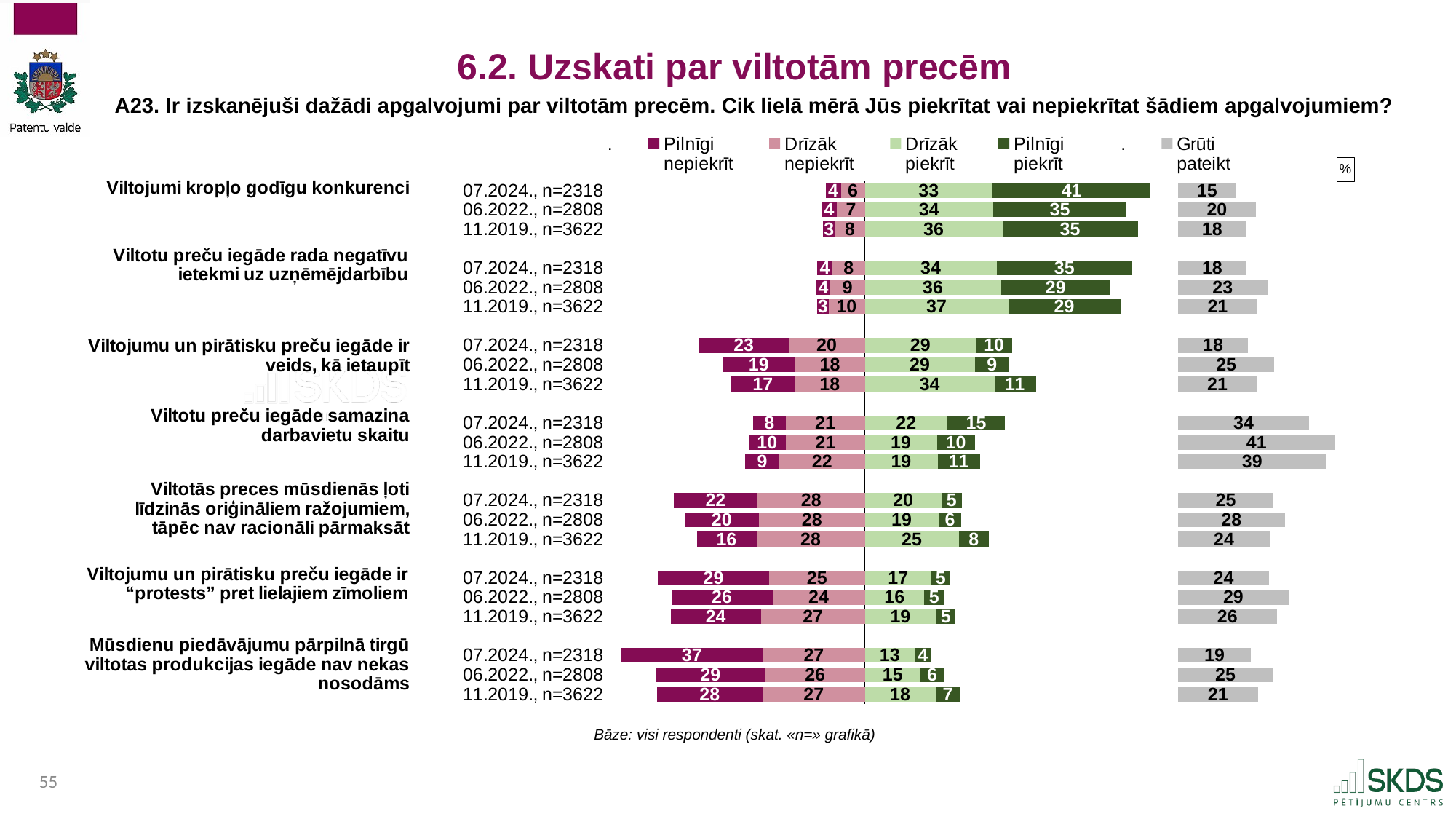
For "Viltojumi kropļo godīgu konkurenci", how much higher is the "Pilnīgi piekrīt" value in 07.2024 than in 06.2022? 6 In the 07.2024 wave, which has the larger "Grūti pateikt" value: "Viltotu preču iegāde samazina darbavietu skaitu" or "Viltojumi kropļo godīgu konkurenci"? Viltotu preču iegāde samazina darbavietu skaitu For "Mūsdienu piedāvājumu pārpilnā tirgū viltotas produkcijas iegāde nav nekas nosodāms", does the "Pilnīgi nepiekrīt" value rise or fall from 11.2019 to 07.2024? Rises What is the "Drīzāk piekrīt" value for "Viltojumu un pirātisku preču iegāde ir veids, kā ietaupīt" in the 11.2019 wave? 34 What colour represents "Grūti pateikt" in the chart? Grey What kind of chart is shown on the slide? Stacked bar chart What is the "Grūti pateikt" value for "Viltotu preču iegāde samazina darbavietu skaitu" in the 06.2022 wave? 41 How many statements are shown in the chart? 7 How many series does the legend list? 5 Among the 07.2024 bars, which statement has the highest "Pilnīgi nepiekrīt" value? Mūsdienu piedāvājumu pārpilnā tirgū viltotas produkcijas iegāde nav nekas nosodāms For the statement "Mūsdienu piedāvājumu pārpilnā tirgū viltotas produkcijas iegāde nav nekas nosodāms" in 07.2024, what percentage answered "Pilnīgi nepiekrīt"? 37 For the statement "Viltojumi kropļo godīgu konkurenci" in the 07.2024 wave, what percentage answered "Pilnīgi piekrīt"? 41